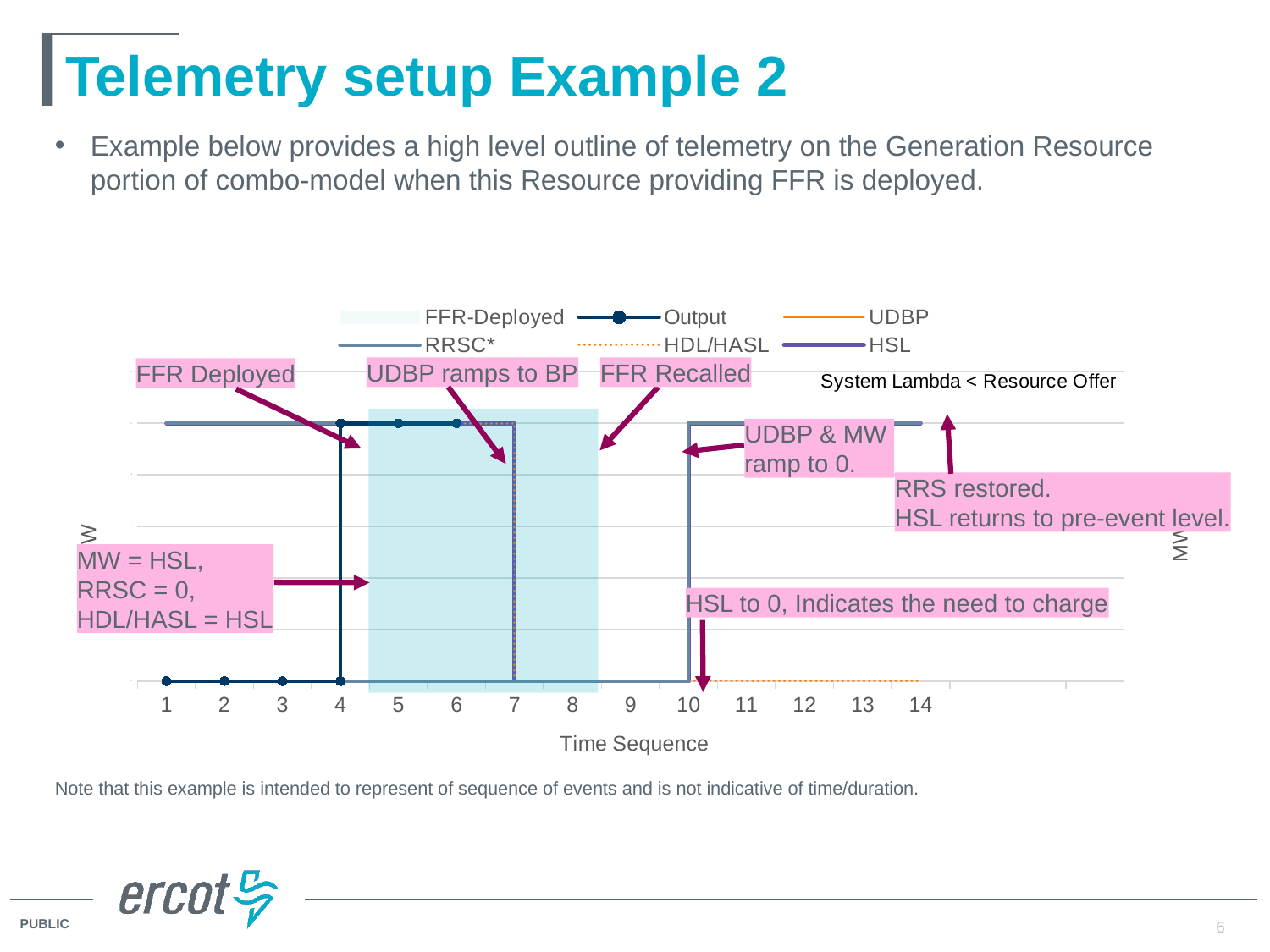
Which legend entry is drawn as a shaded area rather than a line? FFR-Deployed How many series does the chart legend list? 6 How many time sequence points are labelled on the x axis of the chart? 14 Does the Output series rise or fall at time sequence 4? rise Does the Output series rise or fall at time sequence 7? fall What kind of chart is shown on the slide? line chart What is the title of the x axis of the chart? Time Sequence At time sequence 2, is the Output series higher or lower than the HSL series? lower